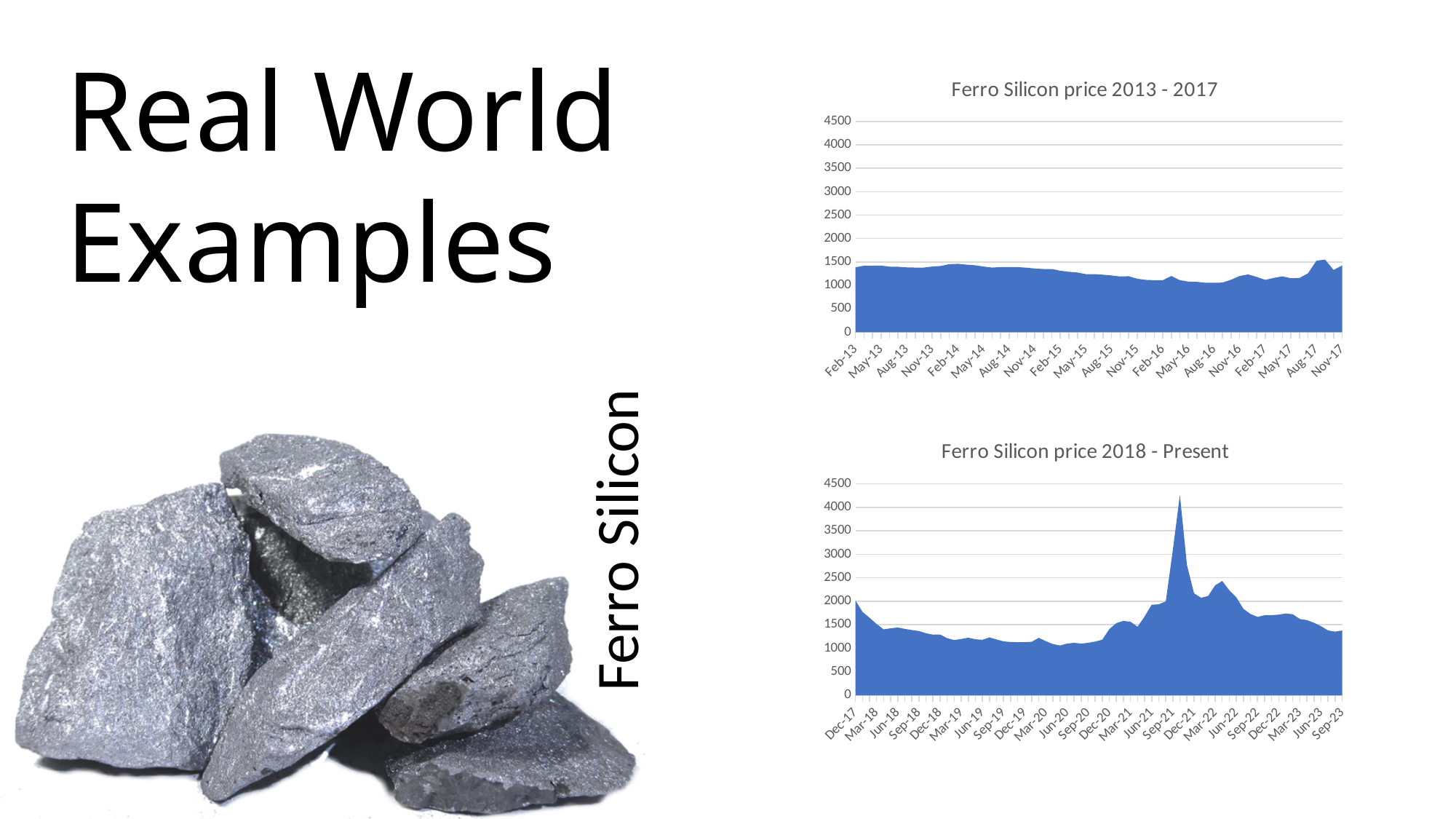
What kind of chart is the 'Ferro Silicon price 2013 - 2017' chart? area chart In the 'Ferro Silicon price 2018 - Present' chart, is the highest value greater or less than 4000? greater What kind of chart is the 'Ferro Silicon price 2018 - Present' chart? area chart In the 'Ferro Silicon price 2018 - Present' chart, is the value for Sep-23 greater or less than 1500? less How many charts are shown on the slide? 2 In the 'Ferro Silicon price 2018 - Present' chart, do values rise or fall from Jun-22 to Sep-23? fall What is the title of the lower chart on the slide? Ferro Silicon price 2018 - Present In the 'Ferro Silicon price 2013 - 2017' chart, is the value for Feb-13 greater or less than 1000? greater What is the title of the upper chart on the slide? Ferro Silicon price 2013 - 2017